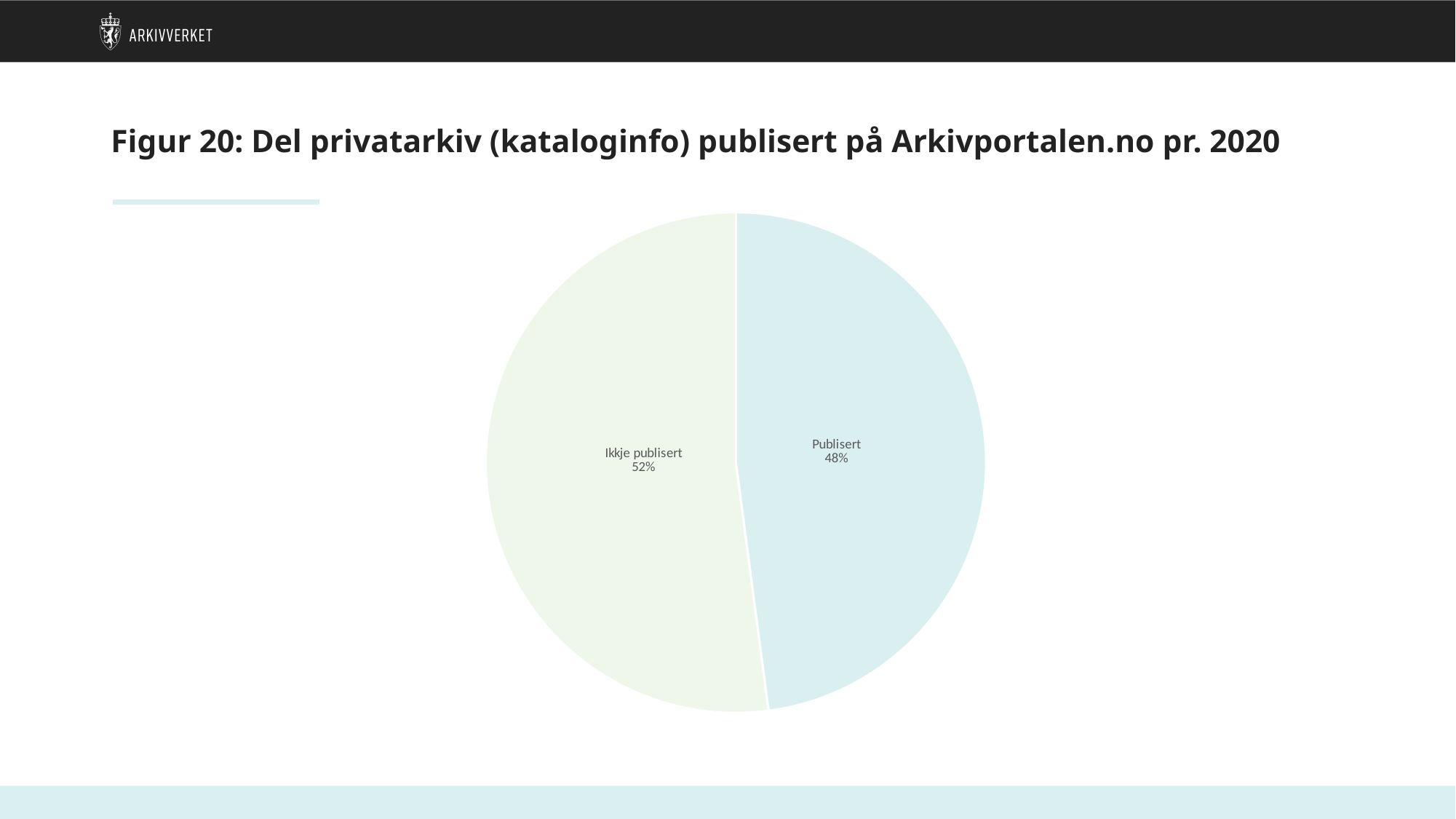
What kind of chart is shown on the slide? pie chart Which slice is the largest? Ikkje publisert What is the difference in percentage points between Ikkje publisert and Publisert? 4 What share of the pie is labelled Ikkje publisert? 52% Which slice is the smallest? Publisert What share of the pie is labelled Publisert? 48% What is the total of the two slice percentages shown? 100% How many slices does the pie chart have? 2 Is the Publisert slice greater or less than 50%? less Which is larger, the Publisert slice or the Ikkje publisert slice? Ikkje publisert What is the title of the slide containing the chart? Figur 20: Del privatarkiv (kataloginfo) publisert på Arkivportalen.no pr. 2020